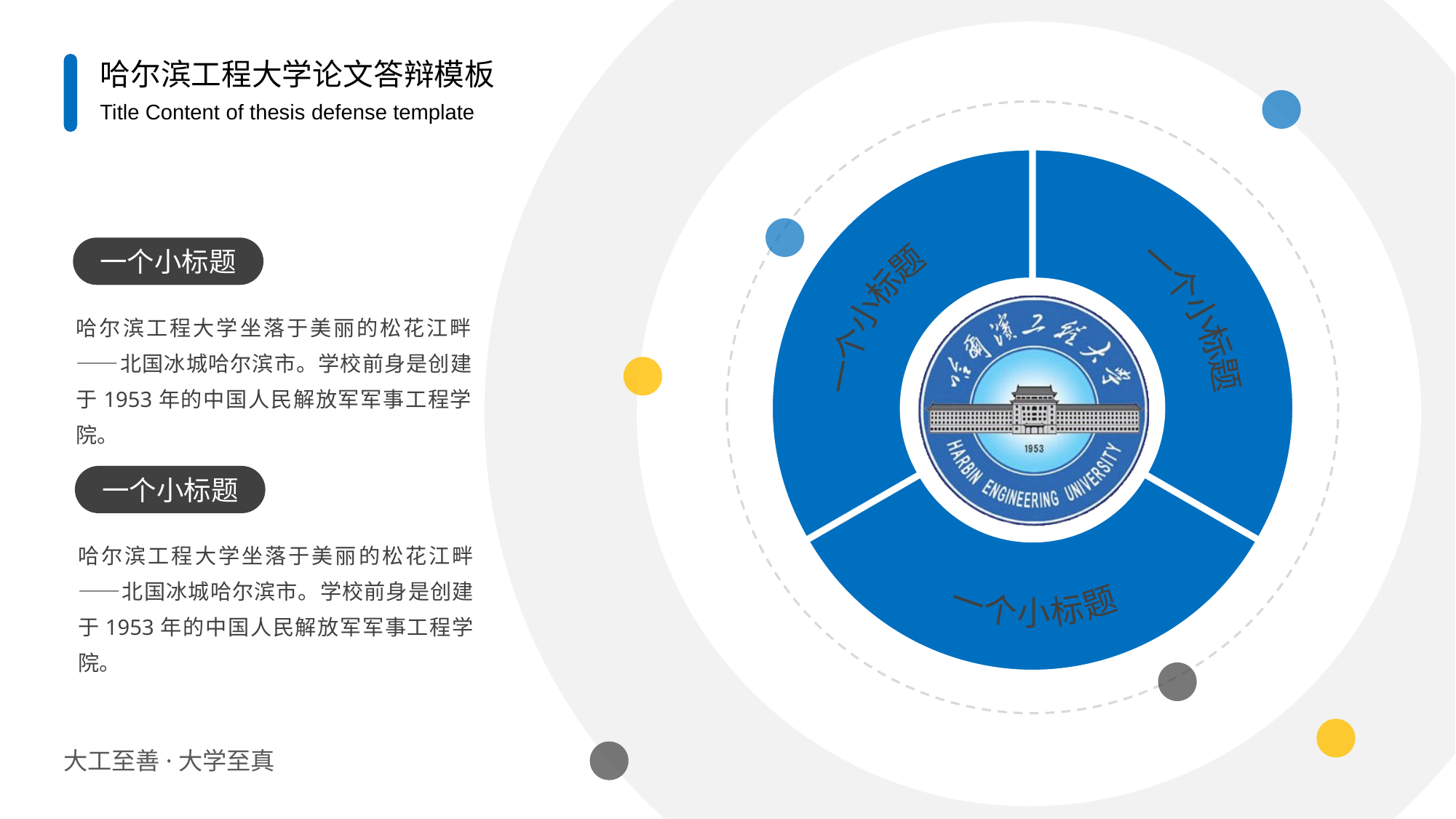
How many segments does the doughnut chart on the slide have? 3 What text label is printed on each segment of the doughnut chart? 一个小标题 Are the three segments of the doughnut chart equal in size, or is one clearly larger than the others? equal What kind of chart is shown on the right side of the slide? doughnut chart What colour are the segments of the doughnut chart? blue